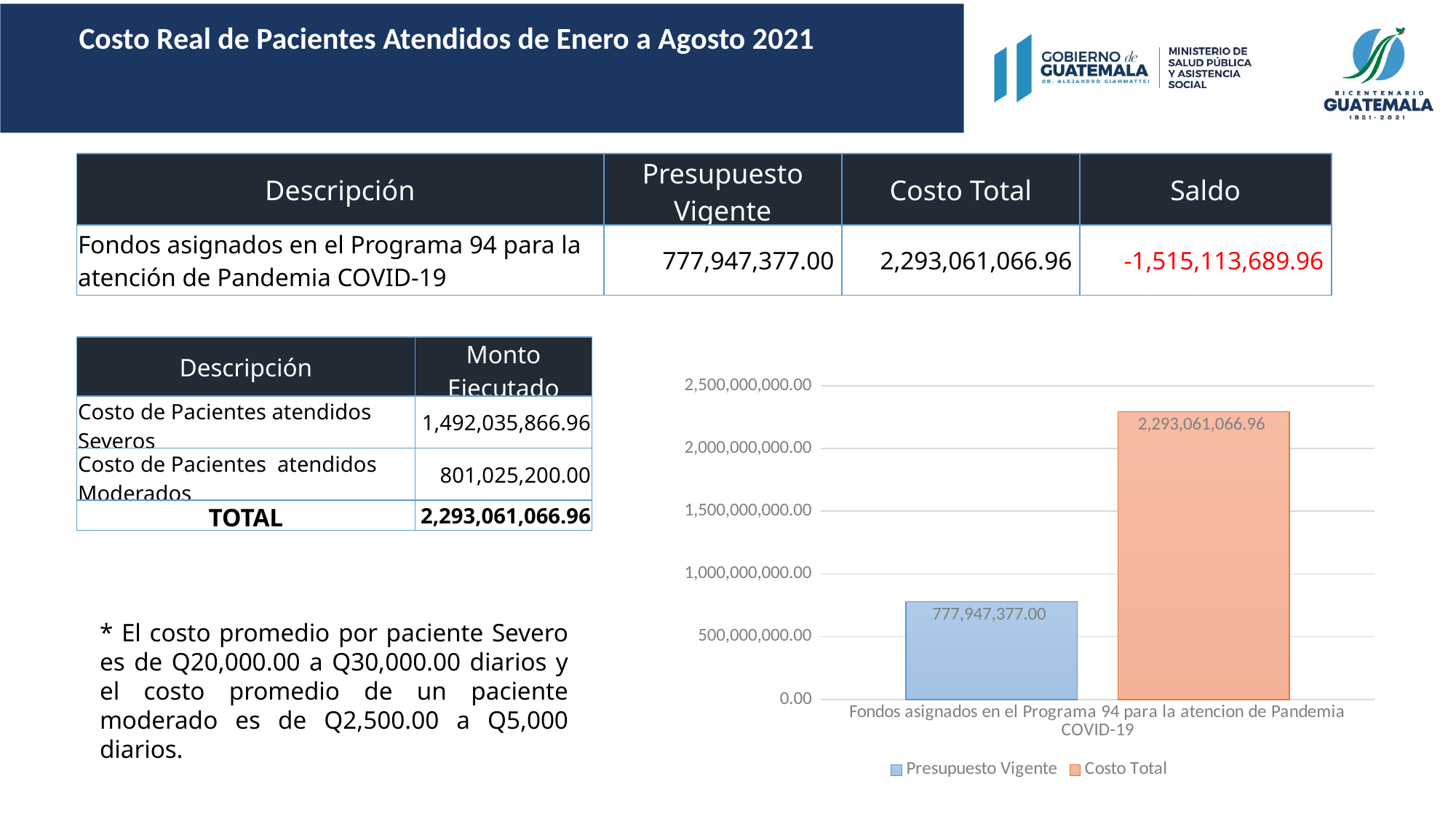
What is the category label on the x axis of the chart? Fondos asignados en el Programa 94 para la atencion de Pandemia COVID-19 How many categories are shown on the x axis of the chart? 1 What is the value of the Costo Total bar in the chart? 2,293,061,066.96 Is the value of the Presupuesto Vigente bar greater or less than 1,000,000,000.00? less What is the value of the Presupuesto Vigente bar in the chart? 777,947,377.00 What is the highest value shown on the chart's y axis? 2,500,000,000.00 Which series has the higher value in the chart, Presupuesto Vigente or Costo Total? Costo Total How many series does the chart legend list? 2 Is the value of the Costo Total bar greater or less than 2,000,000,000.00? greater Which series has the lowest value in the chart? Presupuesto Vigente What is the difference between the Costo Total bar and the Presupuesto Vigente bar? 1,515,113,689.96 What kind of chart is shown on the slide? Bar chart